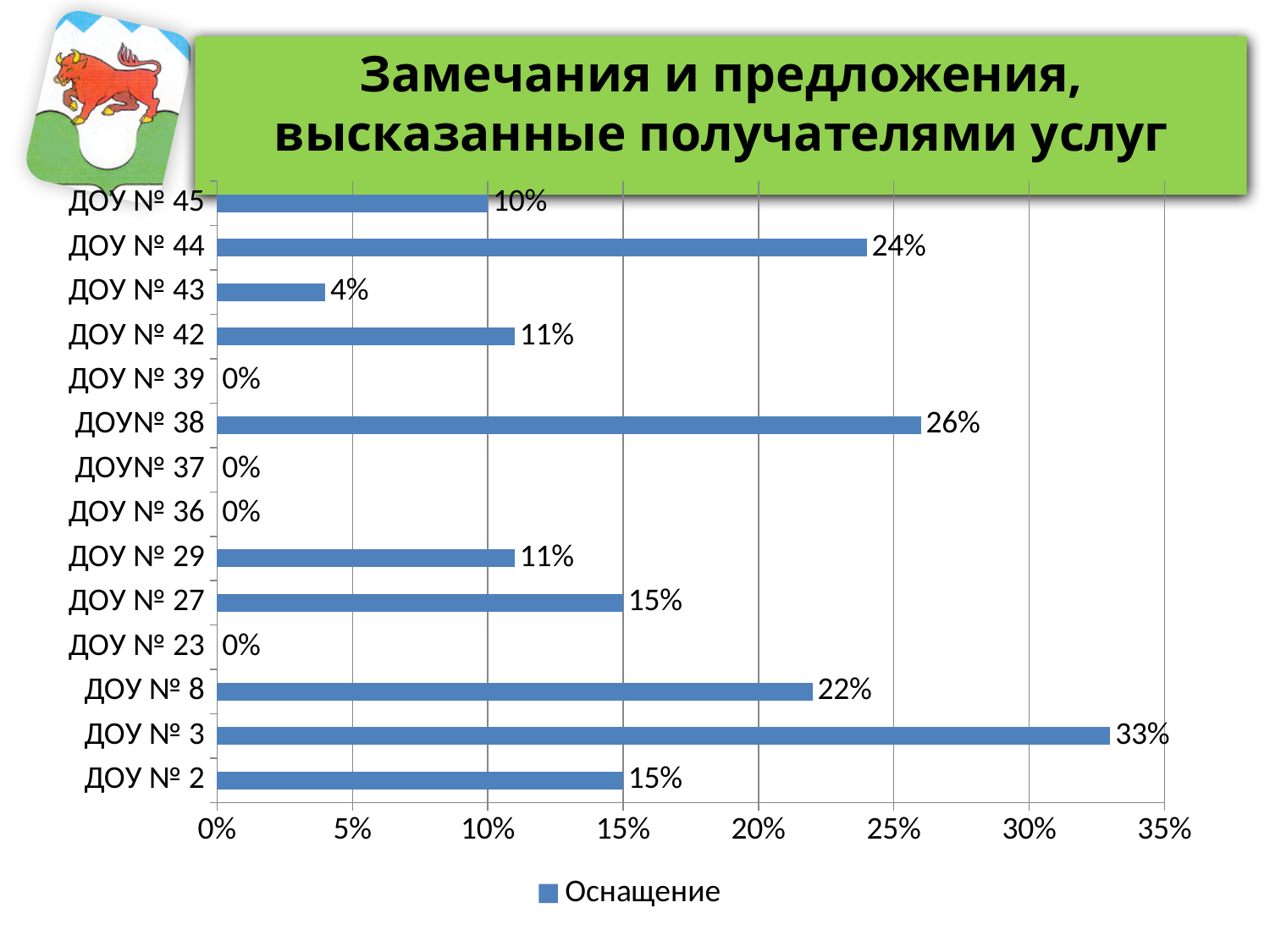
What is the value for ДОУ № 43? 4% Which category has the highest value? ДОУ № 3 What is the value for ДОУ№ 38? 26% What is the value for ДОУ № 44? 24% What series name does the legend show? Оснащение What kind of chart is shown on the slide? bar chart What is the value for ДОУ № 8? 22% Is the value for ДОУ № 45 greater or less than 15%? less Which is larger, the value for ДОУ № 27 or the value for ДОУ № 42? ДОУ № 27 How many categories are shown on the chart? 14 What is the difference between the values for ДОУ № 3 and ДОУ № 44? 9% How many categories have a value of 0%? 4